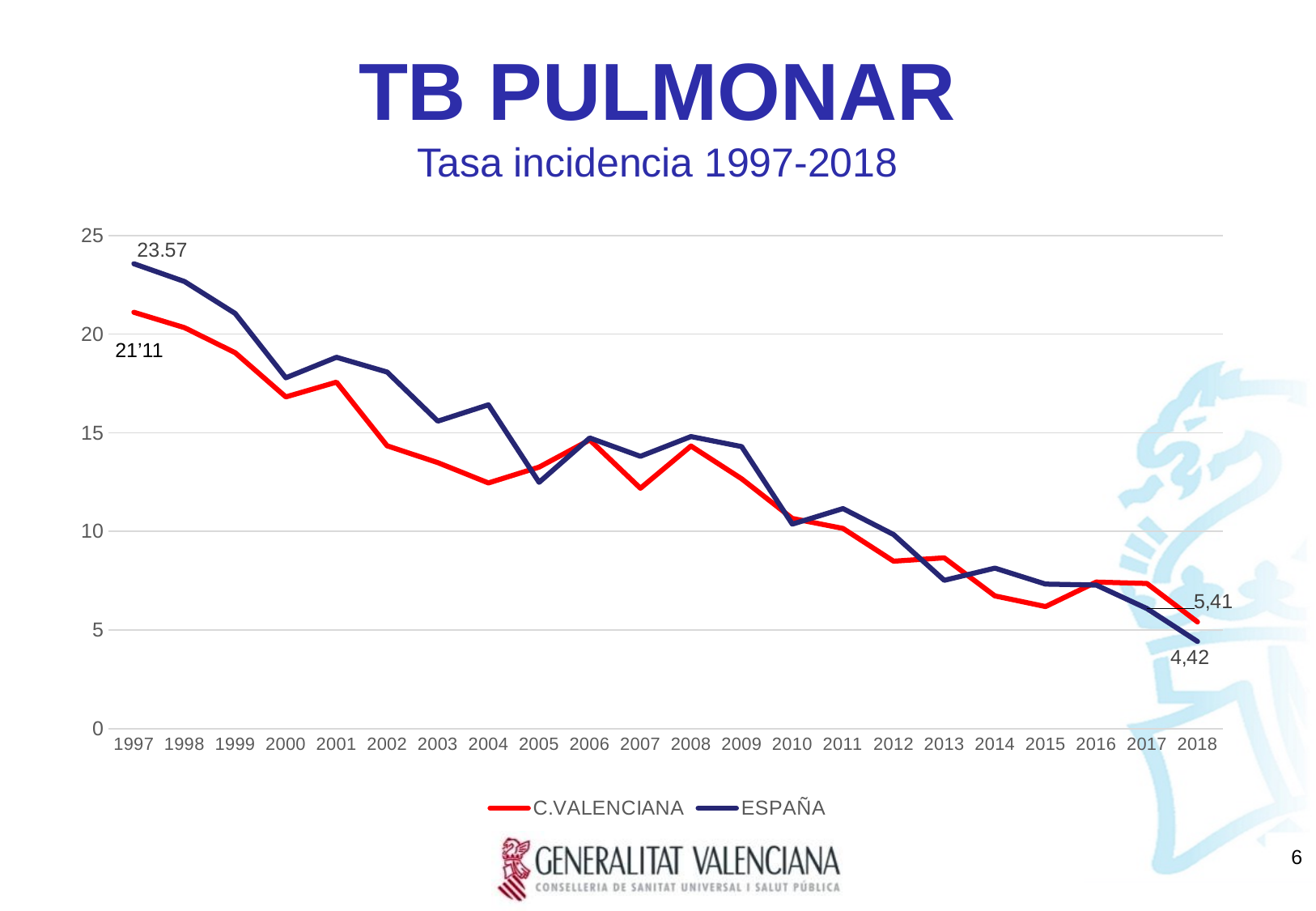
Is the value for C.VALENCIANA in 2004 greater or less than 15? less What is the value for ESPAÑA in 1997? 23.57 What is the value for C.VALENCIANA in 2018? 5,41 In 2018, which series has the higher value, C.VALENCIANA or ESPAÑA? C.VALENCIANA What is the value for ESPAÑA in 2018? 4,42 How many series does the legend list? 2 What kind of chart is shown on the slide? line chart What is the value for C.VALENCIANA in 1997? 21'11 In 1997, which series has the higher value, C.VALENCIANA or ESPAÑA? ESPAÑA What is the difference between the C.VALENCIANA and ESPAÑA values in 2018? 0,99 Is the value for ESPAÑA in 2001 greater or less than 15? greater How many years are shown on the x axis? 22